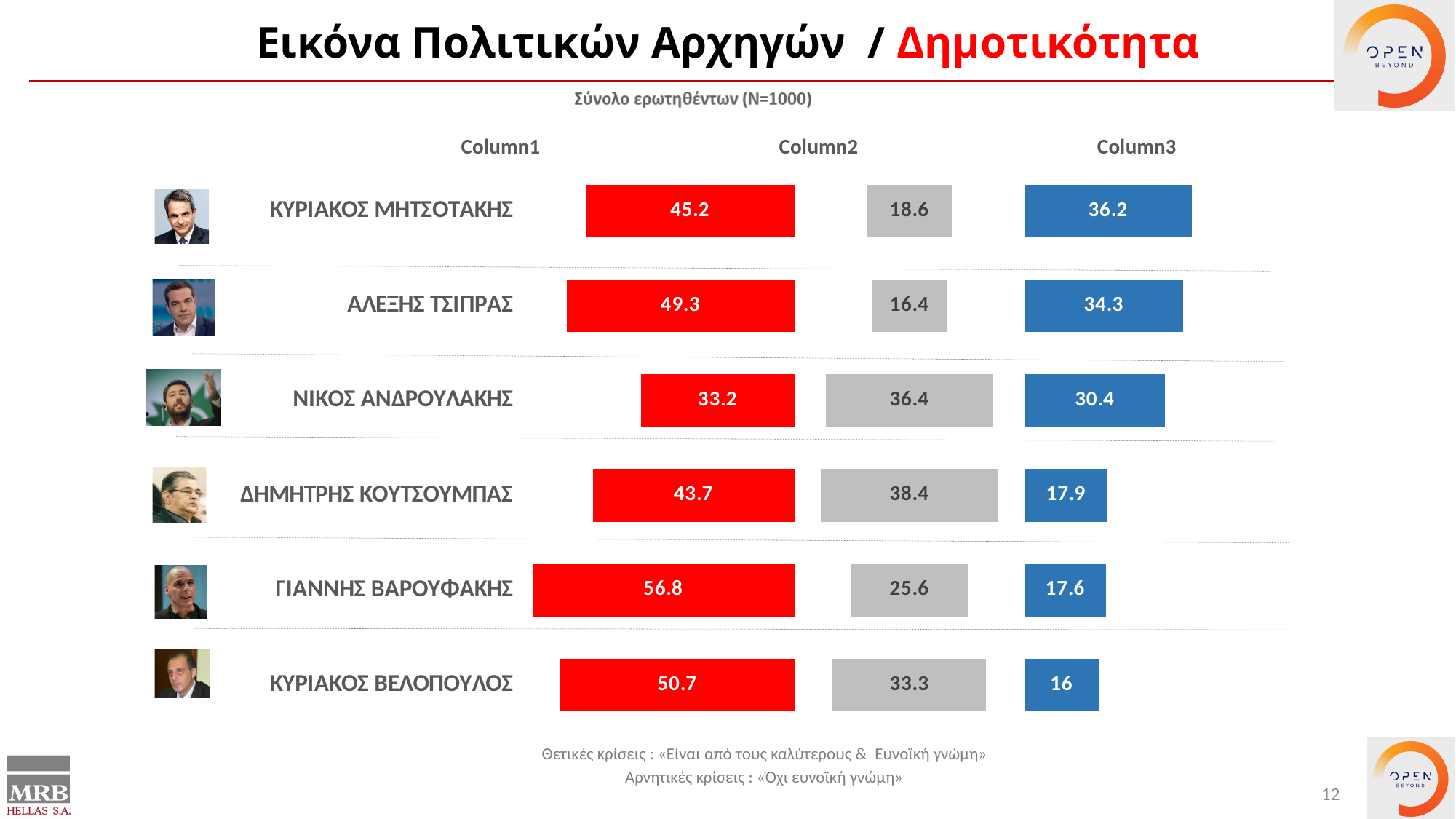
Which politician has the highest Column3 value? ΚΥΡΙΑΚΟΣ ΜΗΤΣΟΤΑΚΗΣ How many series (columns) does the chart show? 3 What colour are the Column1 bars? Red Which is larger: the Column2 value for ΝΙΚΟΣ ΑΝΔΡΟΥΛΑΚΗΣ or the Column2 value for ΚΥΡΙΑΚΟΣ ΒΕΛΟΠΟΥΛΟΣ? ΝΙΚΟΣ ΑΝΔΡΟΥΛΑΚΗΣ What is the difference between the Column1 values of ΓΙΑΝΝΗΣ ΒΑΡΟΥΦΑΚΗΣ and ΚΥΡΙΑΚΟΣ ΜΗΤΣΟΤΑΚΗΣ? 11.6 What is the Column1 value for ΚΥΡΙΑΚΟΣ ΜΗΤΣΟΤΑΚΗΣ? 45.2 Which politician has the highest Column1 value? ΓΙΑΝΝΗΣ ΒΑΡΟΥΦΑΚΗΣ How many politicians are shown in the chart? 6 What is the Column3 value for ΚΥΡΙΑΚΟΣ ΒΕΛΟΠΟΥΛΟΣ? 16 Which politician has the lowest Column2 value? ΑΛΕΞΗΣ ΤΣΙΠΡΑΣ What kind of chart is shown on the slide? Bar chart What is the Column2 value for ΔΗΜΗΤΡΗΣ ΚΟΥΤΣΟΥΜΠΑΣ? 38.4